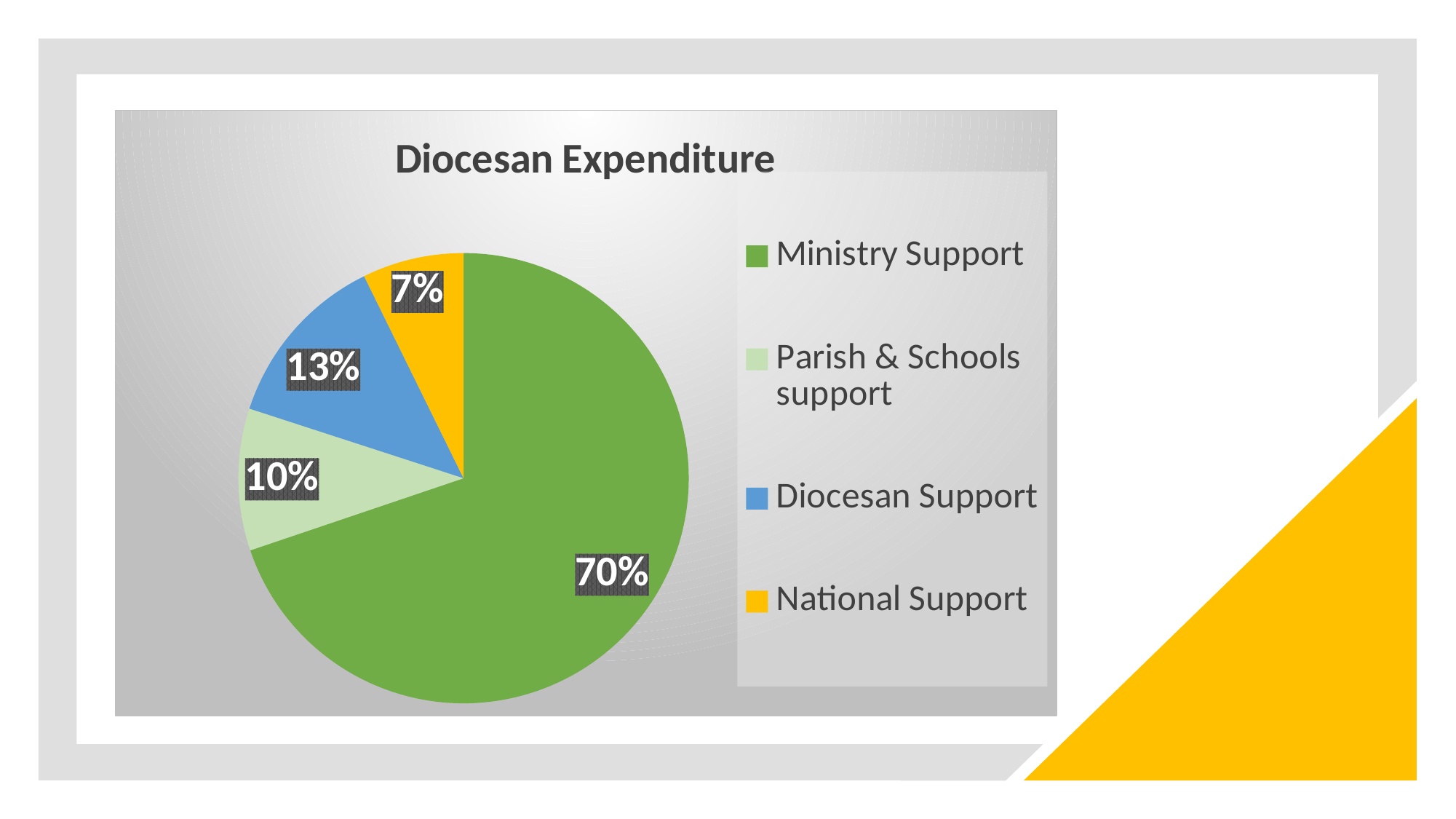
What share of Diocesan Expenditure goes to National Support? 7% What share of Diocesan Expenditure goes to Ministry Support? 70% How many categories does the pie chart show? 4 What is the title of the chart? Diocesan Expenditure Which category has the smallest share of Diocesan Expenditure? National Support What share of Diocesan Expenditure goes to Diocesan Support? 13% Which is larger, the share for Diocesan Support or the share for Parish & Schools support? Diocesan Support What colour is the National Support slice? yellow What kind of chart is shown on the slide? pie chart Which category has the largest share of Diocesan Expenditure? Ministry Support What is the difference in percentage points between Ministry Support and Diocesan Support? 57